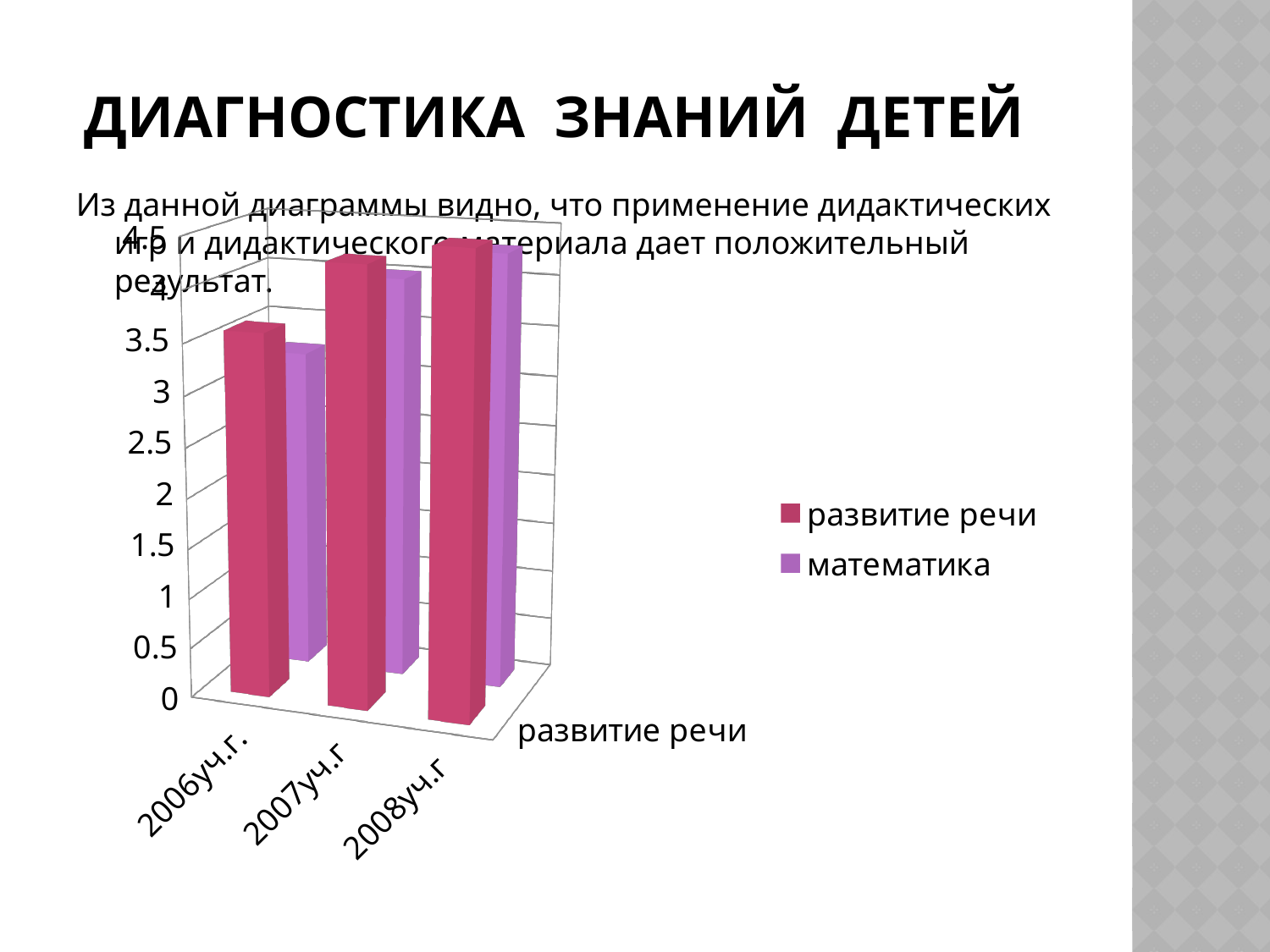
In which year is the value for развитие речи highest? 2008уч.г Which is larger for развитие речи: the value in 2006уч.г. or in 2008уч.г? 2008уч.г What are the two series named in the legend? развитие речи, математика How many series does the legend list? 2 Is the value for развитие речи in 2006уч.г. greater or less than 3? greater Do the values for развитие речи rise or fall from 2006уч.г. to 2008уч.г? rise In which year is the value for математика lowest? 2006уч.г. Is the value for математика in 2006уч.г. greater or less than 4? less Which series is shown in purple in the legend? математика How many categories (school years) are shown on the x axis? 3 What kind of chart is shown on the slide? bar chart Is the value for развитие речи in 2008уч.г greater or less than 4? greater